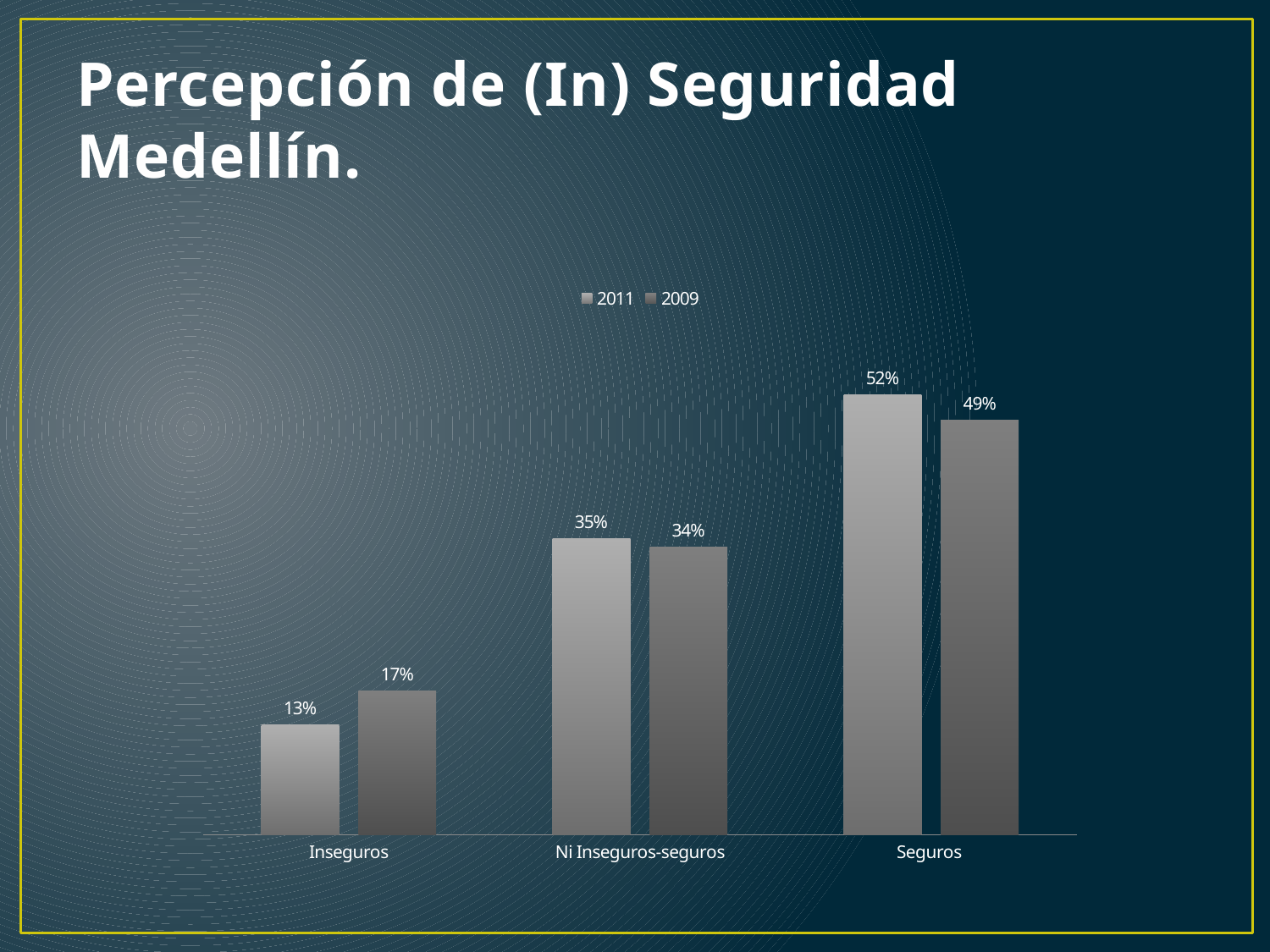
How many categories are shown on the x axis? 3 What is the difference between the 2011 and 2009 values for Seguros? 3% Which category has the highest value in the 2011 series? Seguros What is the value for Ni Inseguros-seguros in the 2011 series? 35% Which is larger for Ni Inseguros-seguros, the 2011 value or the 2009 value? 2011 What kind of chart is shown on the slide? Bar chart What is the difference between the 2011 and 2009 values for Inseguros? 4% What is the value for Seguros in the 2011 series? 52% Which category has the lowest value in the 2009 series? Inseguros What is the value for Inseguros in the 2009 series? 17% What is the value for Seguros in the 2009 series? 49% How many series does the legend list? 2